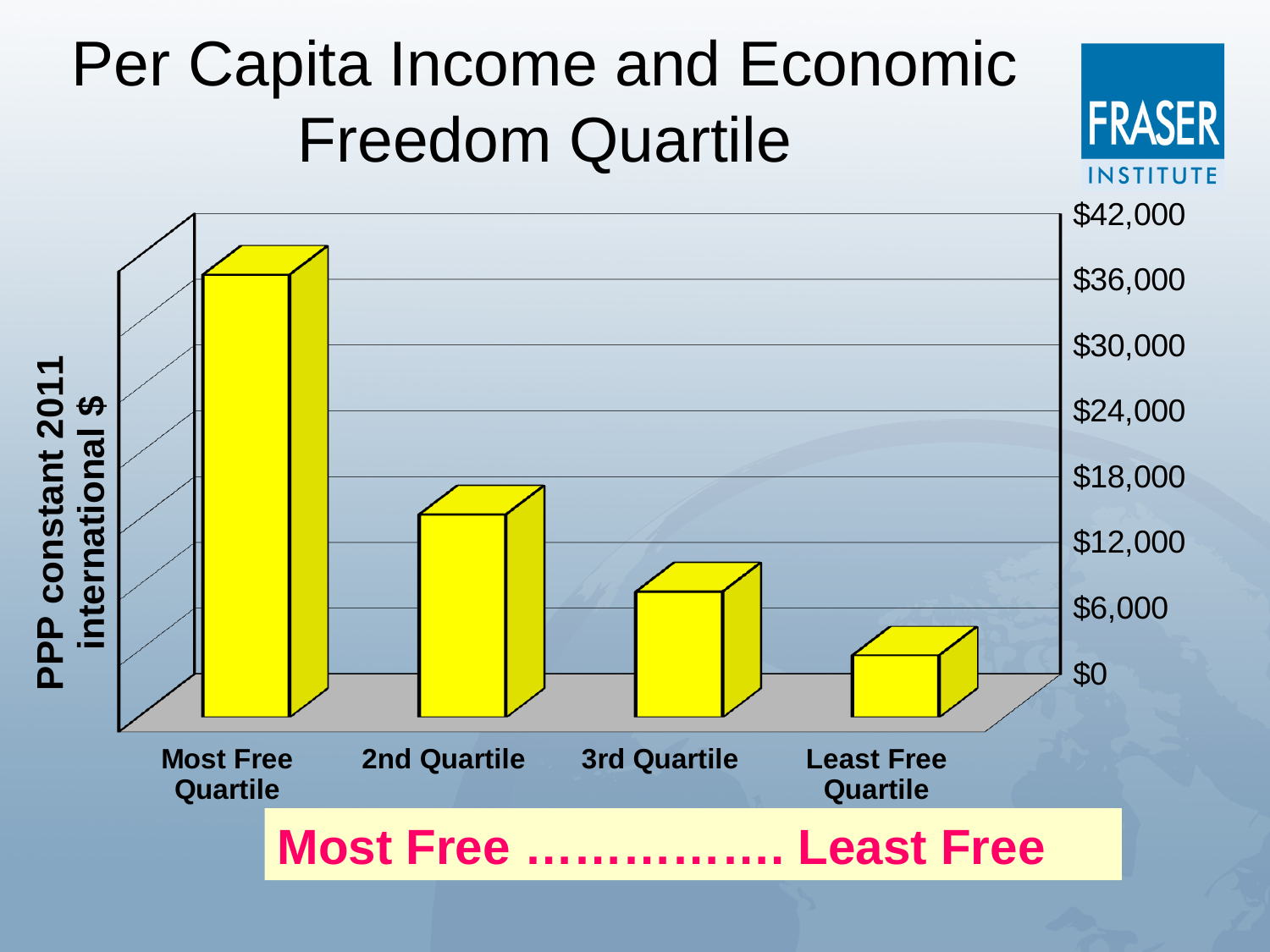
Which quartile has the highest per capita income? Most Free Quartile Which quartile has the lowest per capita income? Least Free Quartile What is the label on the vertical axis of the chart? PPP constant 2011 international $ Which has a higher per capita income, the 2nd Quartile or the 3rd Quartile? 2nd Quartile What kind of chart is shown on the slide? bar chart Do the bar values rise or fall moving from the Most Free Quartile to the Least Free Quartile? fall Is the value for the Most Free Quartile greater or less than $30,000? greater Is the value for the 2nd Quartile greater or less than $30,000? less Is the value for the 3rd Quartile greater or less than $24,000? less What is the title of the chart? Per Capita Income and Economic Freedom Quartile How many quartile categories are plotted on the chart? 4